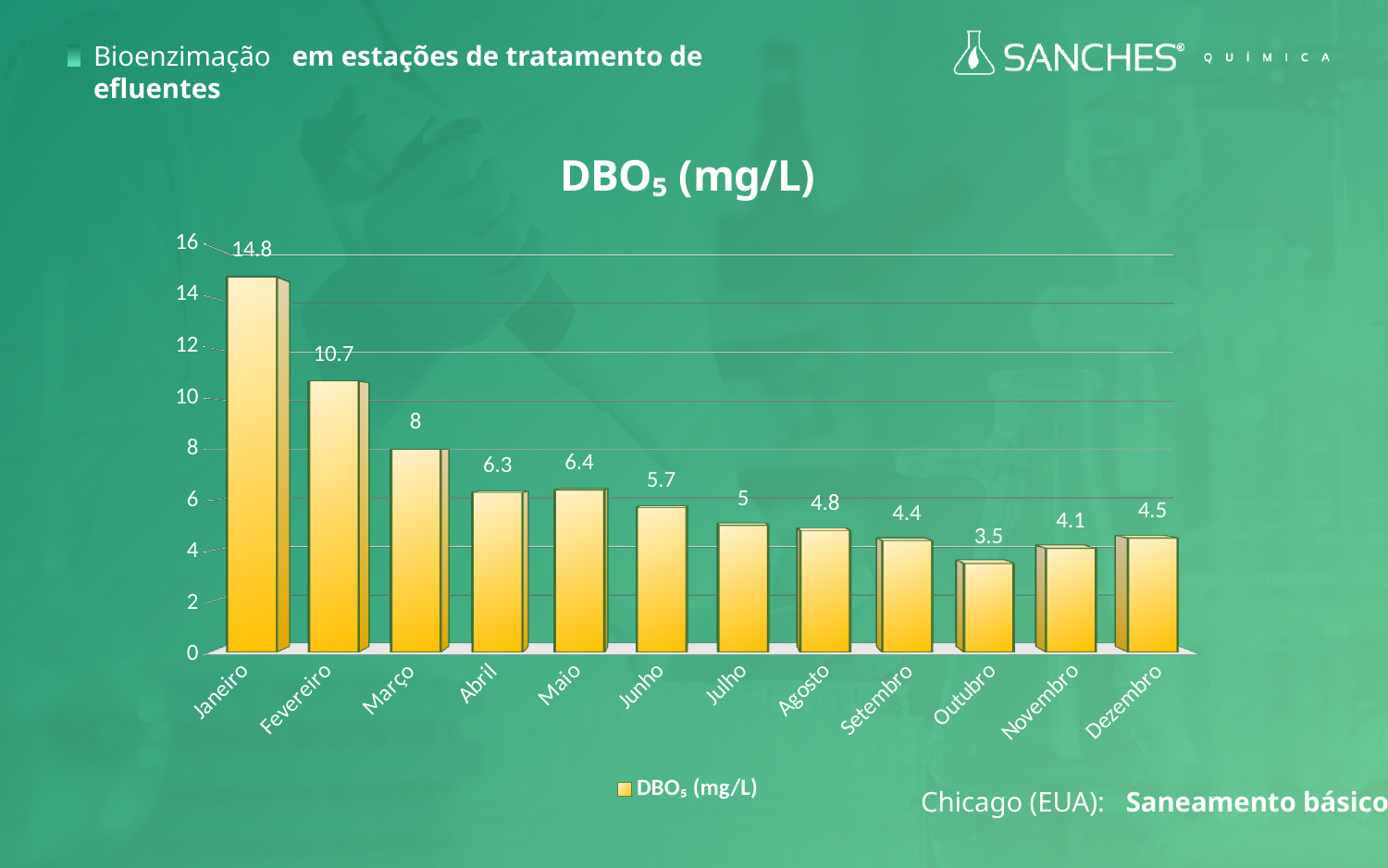
How many months are shown on the x axis? 12 Which month has a larger DBO5 value, Março or Junho? Março What is the title of the chart? DBO5 (mg/L) What is the DBO5 value for Outubro? 3.5 How many series does the legend list? 1 Which month has the highest DBO5 value? Janeiro What is the difference between the DBO5 values for Janeiro and Fevereiro? 4.1 What is the DBO5 value for Janeiro? 14.8 What is the DBO5 value for Maio? 6.4 Do the DBO5 values generally rise or fall from Janeiro to Outubro? Fall What kind of chart is shown on the slide? Bar chart Which month has the lowest DBO5 value? Outubro